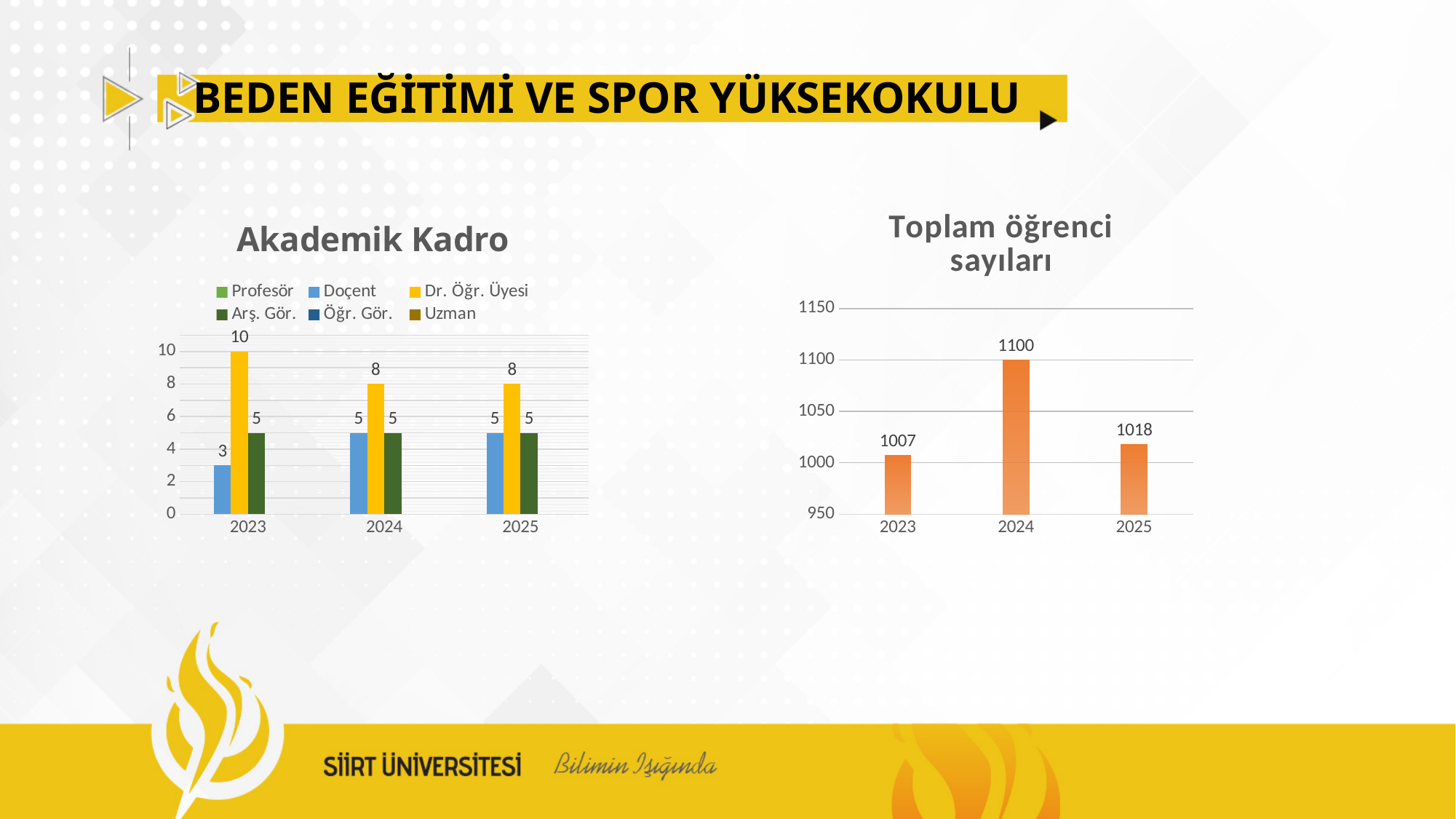
In the 'Toplam öğrenci sayıları' chart, how many years are shown on the x axis? 3 In the 'Akademik Kadro' chart, what is the value for Dr. Öğr. Üyesi in 2023? 10 In the 'Toplam öğrenci sayıları' chart, what is the value for 2023? 1007 In the 'Akademik Kadro' chart, how many series does the legend list? 6 In the 'Akademik Kadro' chart, what is the value for Arş. Gör. in 2025? 5 In the 'Toplam öğrenci sayıları' chart, which year has the lowest value? 2023 What kind of chart is the 'Toplam öğrenci sayıları' chart? bar chart In the 'Toplam öğrenci sayıları' chart, what is the difference between the values for 2024 and 2025? 82 In the 'Akademik Kadro' chart, what is the value for Doçent in 2023? 3 In the 'Akademik Kadro' chart, is the value for Doçent in 2024 larger or smaller than the value for Doçent in 2023? larger In the 'Toplam öğrenci sayıları' chart, what is the value for 2024? 1100 In the 'Akademik Kadro' chart, which series has the highest value in 2024? Dr. Öğr. Üyesi